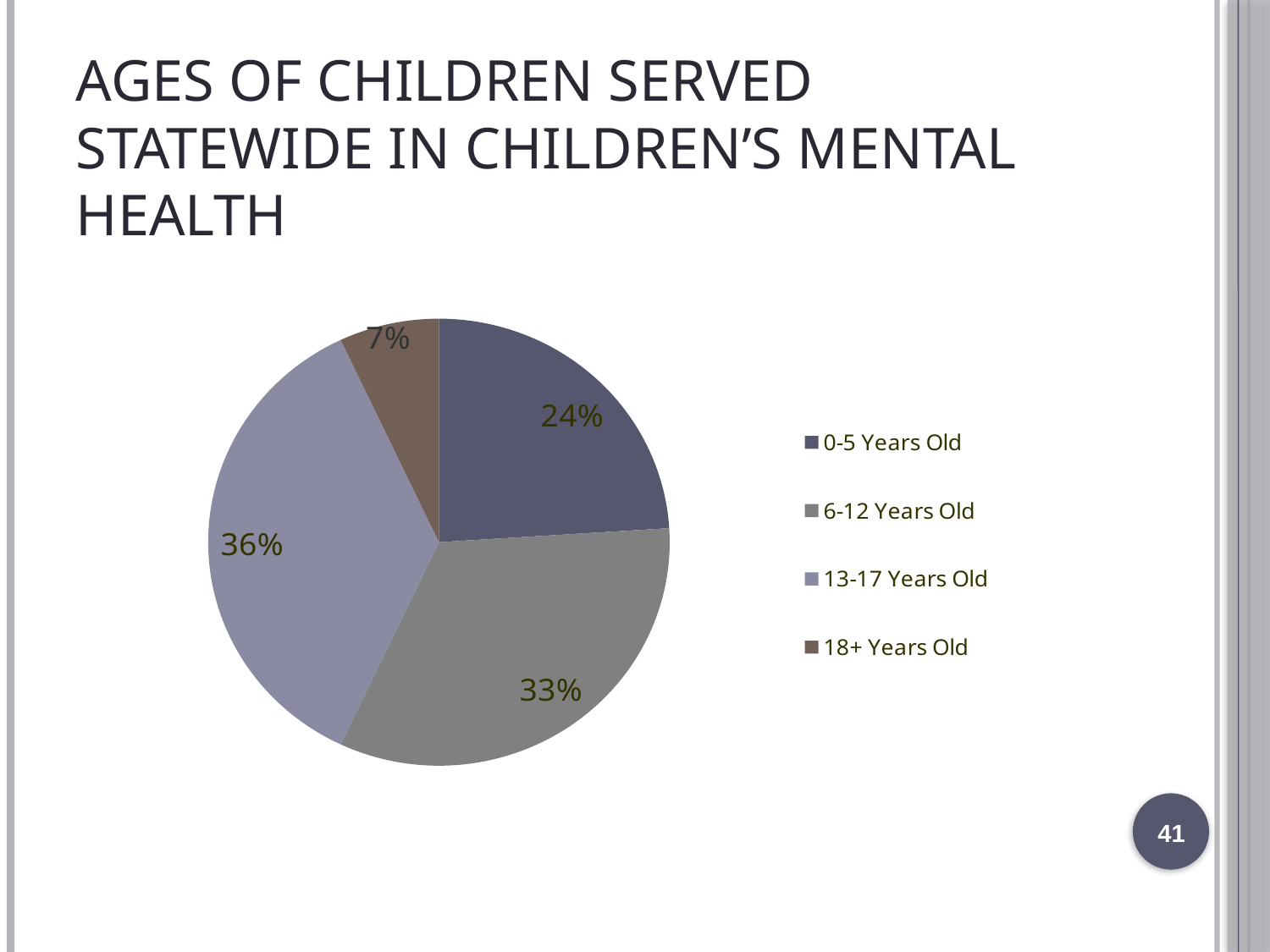
What share of children served are 13-17 Years Old? 36% What is the title of the slide containing the chart? Ages of Children Served Statewide in Children's Mental Health What is the combined share of the 0-5 Years Old and 18+ Years Old slices? 31% What share of children served are 0-5 Years Old? 24% Which slice is larger: 6-12 Years Old or 0-5 Years Old? 6-12 Years Old What kind of chart is shown on the slide? Pie chart What share of children served are 18+ Years Old? 7% Which age group has the largest share of the pie? 13-17 Years Old What share of children served are 6-12 Years Old? 33% How many age groups are shown in the pie chart? 4 What is the difference in percentage points between the 13-17 Years Old and 0-5 Years Old slices? 12 Which age group has the smallest share of the pie? 18+ Years Old